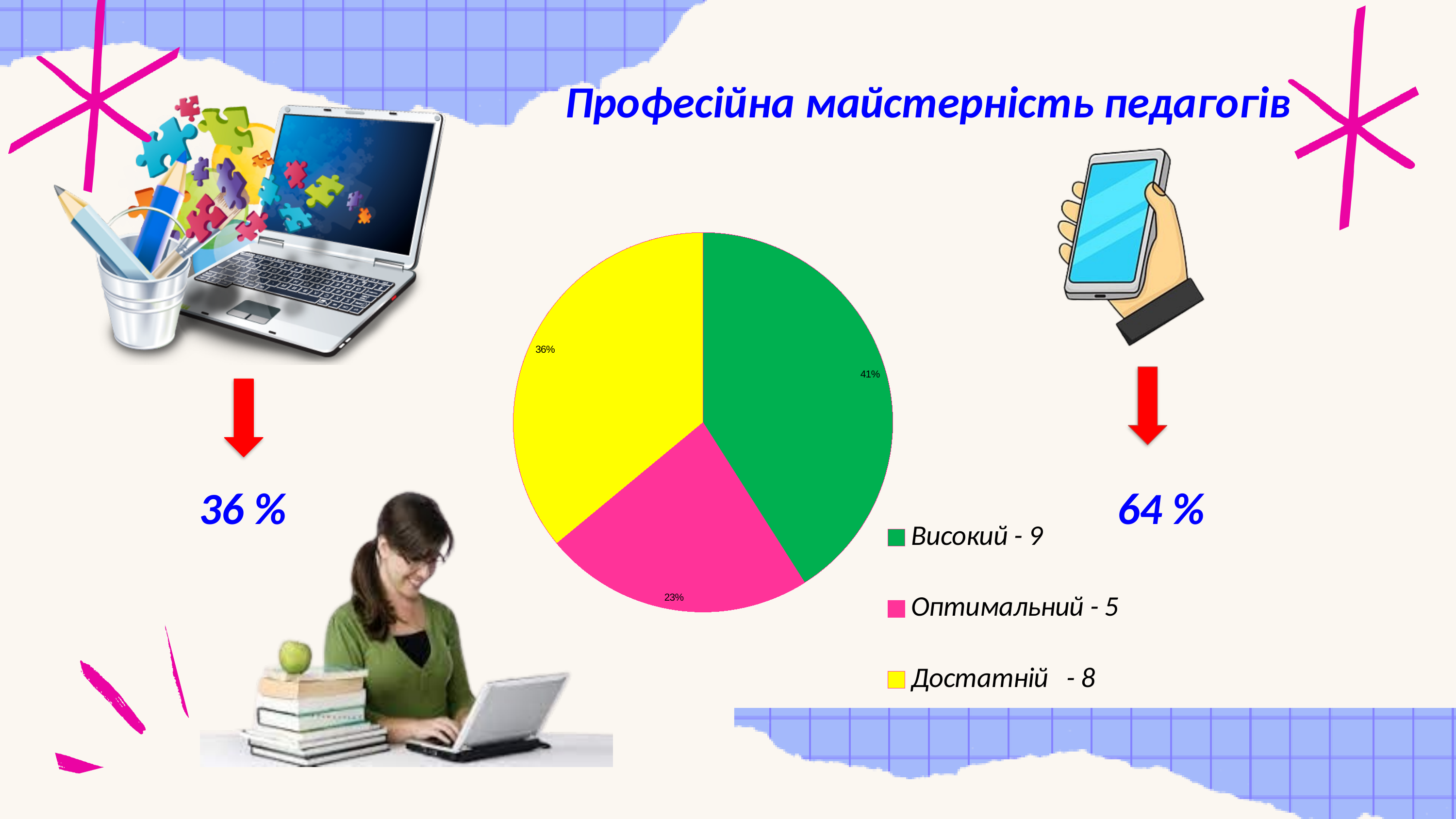
Which category has the smallest share of the pie? Оптимальний What percentage is shown for the Оптимальний slice? 23% What kind of chart is shown on the slide? pie chart How many slices does the pie chart have? 3 What percentage is shown for the Високий slice? 41% Which category has the largest share of the pie? Високий How many entries does the legend list? 3 What is the difference in percentage points between the Високий and Оптимальний slices? 18 Which slice is larger, Достатній or Оптимальний? Достатній What colour is the Оптимальний slice? pink What percentage is shown for the Достатній slice? 36% What number is shown next to Достатній in the legend? 8